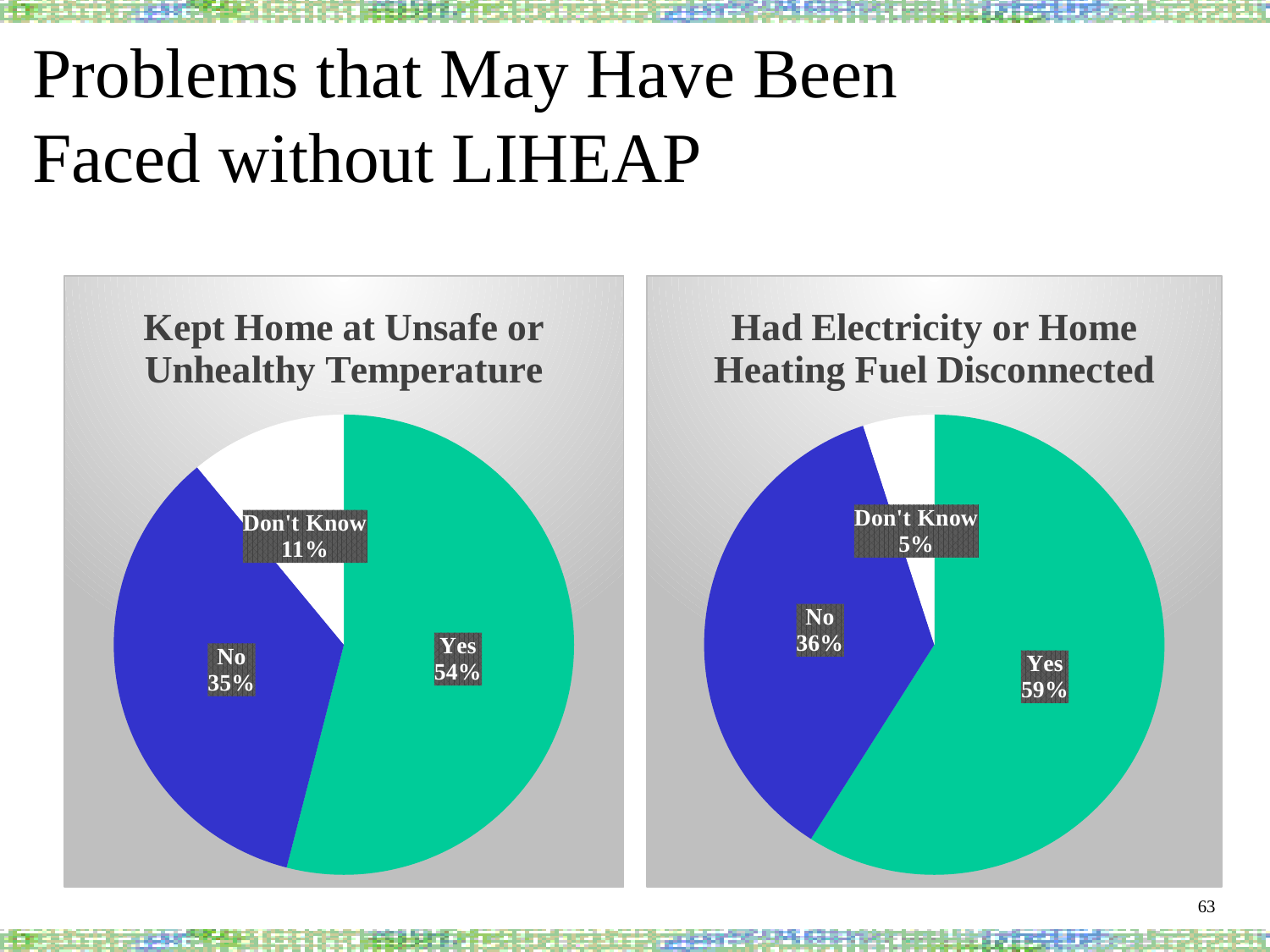
What type of chart is used on the left side of the slide? Pie chart In the 'Kept Home at Unsafe or Unhealthy Temperature' chart, what share of respondents answered Yes? 54% In the 'Had Electricity or Home Heating Fuel Disconnected' chart, what share answered Don't Know? 5% In the 'Had Electricity or Home Heating Fuel Disconnected' chart, what is the difference in percentage points between Yes and No? 23 In the 'Kept Home at Unsafe or Unhealthy Temperature' chart, which response has the smallest slice? Don't Know In the 'Kept Home at Unsafe or Unhealthy Temperature' chart, what is the difference in percentage points between Yes and No? 19 What colour is the Yes slice in the 'Had Electricity or Home Heating Fuel Disconnected' chart? Green In the 'Kept Home at Unsafe or Unhealthy Temperature' chart, what share answered Don't Know? 11% How many slices does the 'Kept Home at Unsafe or Unhealthy Temperature' pie chart have? 3 Which chart has the larger Yes share: 'Kept Home at Unsafe or Unhealthy Temperature' or 'Had Electricity or Home Heating Fuel Disconnected'? Had Electricity or Home Heating Fuel Disconnected In the 'Had Electricity or Home Heating Fuel Disconnected' chart, what share of respondents answered No? 36% In the 'Had Electricity or Home Heating Fuel Disconnected' chart, which response has the largest slice? Yes